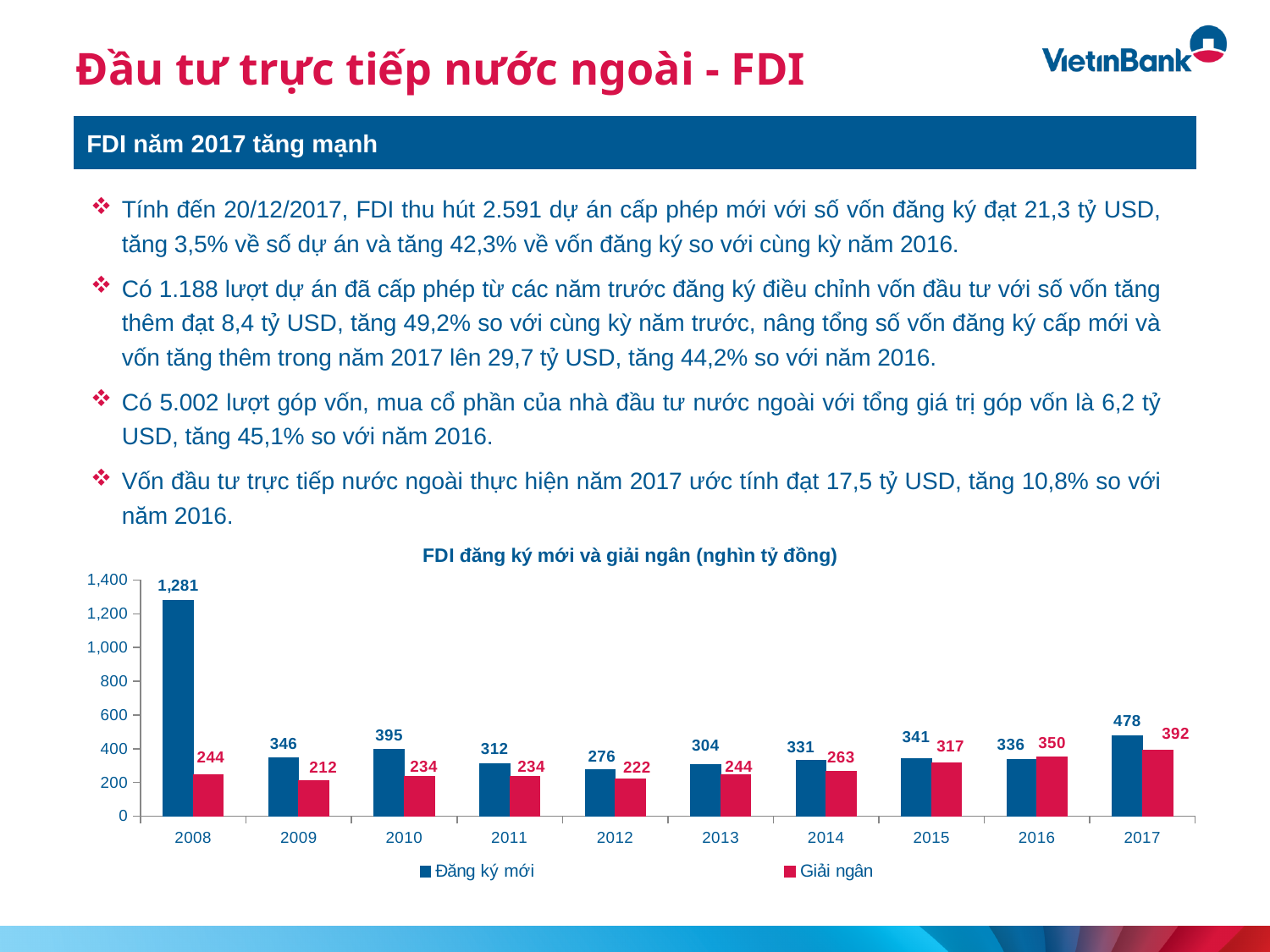
What is the value of Giải ngân for 2017? 392 Which year has the lowest Giải ngân value? 2009 What is the value of Đăng ký mới for 2014? 331 What is the value of Đăng ký mới for 2008? 1,281 How many series does the legend list? 2 What kind of chart is shown on the slide? Bar chart Which year has the highest Đăng ký mới value? 2008 Which is larger in 2016, Đăng ký mới or Giải ngân? Giải ngân What is the title of the chart? FDI đăng ký mới và giải ngân (nghìn tỷ đồng) How many years are shown on the x axis? 10 Is the value of Đăng ký mới for 2010 greater or less than 200? greater What is the difference between Đăng ký mới and Giải ngân in 2017? 86